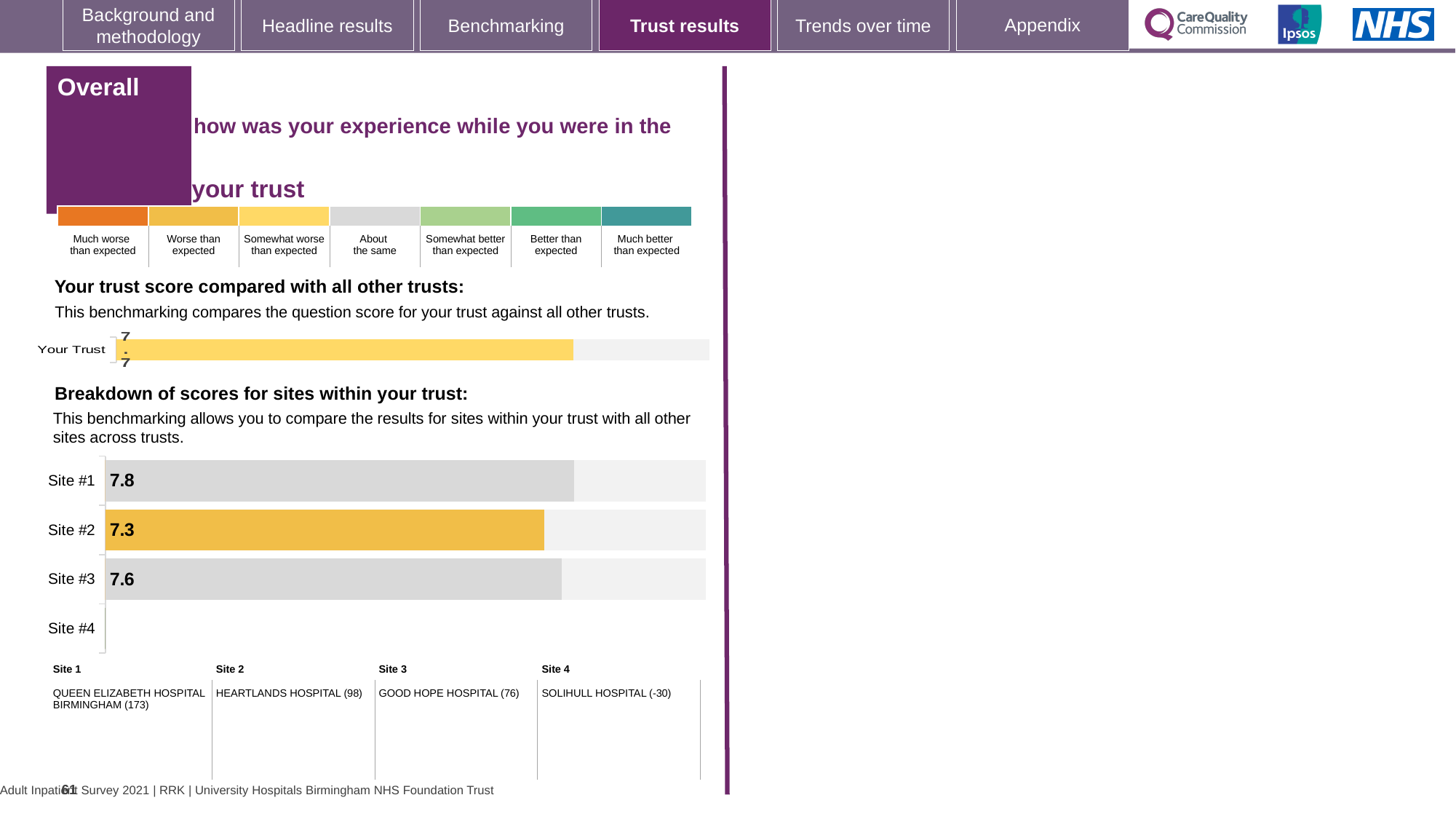
In the 'Breakdown of scores for sites within your trust' chart, what is the score for Site #3? 7.6 In the 'Breakdown of scores for sites within your trust' chart, which has the higher score, Site #2 or Site #3? Site #3 In the 'Breakdown of scores for sites within your trust' chart, what is the score for Site #1? 7.8 In the 'Breakdown of scores for sites within your trust' chart, which site has the highest score? Site #1 In the 'Breakdown of scores for sites within your trust' chart, what is the difference between the scores for Site #1 and Site #2? 0.5 In the 'Breakdown of scores for sites within your trust' chart, which site's bar is coloured yellow rather than grey? Site #2 How many site categories are listed on the axis of the 'Breakdown of scores for sites within your trust' chart? 4 What kind of chart is the 'Breakdown of scores for sites within your trust' chart? Bar chart In the 'Your trust score compared with all other trusts' chart, what is the score shown for Your Trust? 7.7 In the 'Breakdown of scores for sites within your trust' chart, what is the score for Site #2? 7.3 In the 'Breakdown of scores for sites within your trust' chart, which of the sites with a plotted bar has the lowest score? Site #2 In the 'Breakdown of scores for sites within your trust' chart, which site has no bar plotted? Site #4